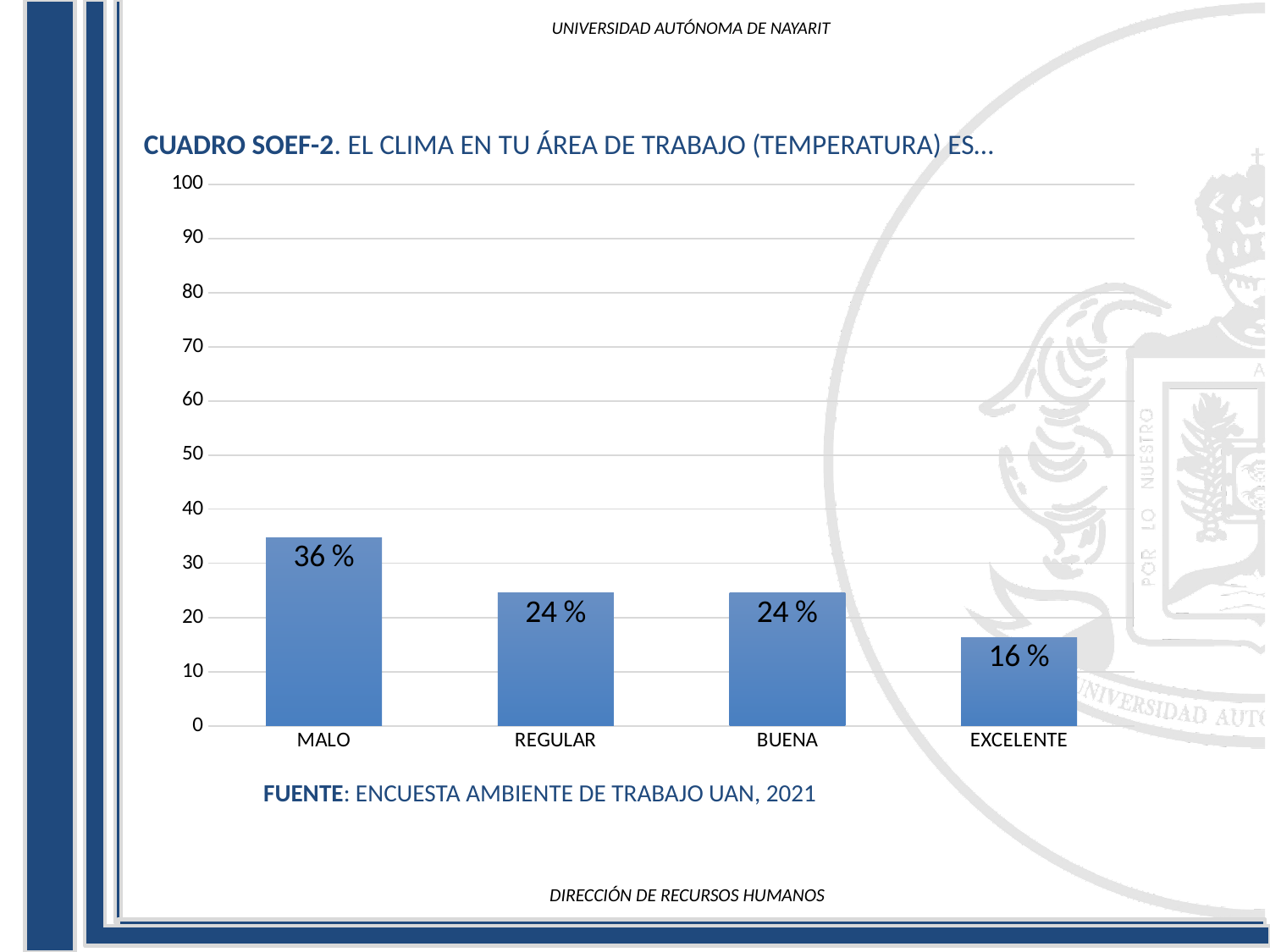
What is the value for REGULAR? 24 % What is the source cited below the chart? ENCUESTA AMBIENTE DE TRABAJO UAN, 2021 How many categories are shown on the x axis? 4 Which category has the highest value? MALO What is the value for MALO? 36 % What is the difference between the values for MALO and BUENA? 12 % Is the value for MALO greater or less than 30? greater Which is larger, the value for MALO or the value for REGULAR? MALO What is the difference between the values for MALO and EXCELENTE? 20 % What kind of chart is shown on the slide? bar chart Which category has the lowest value? EXCELENTE What is the value for EXCELENTE? 16 %